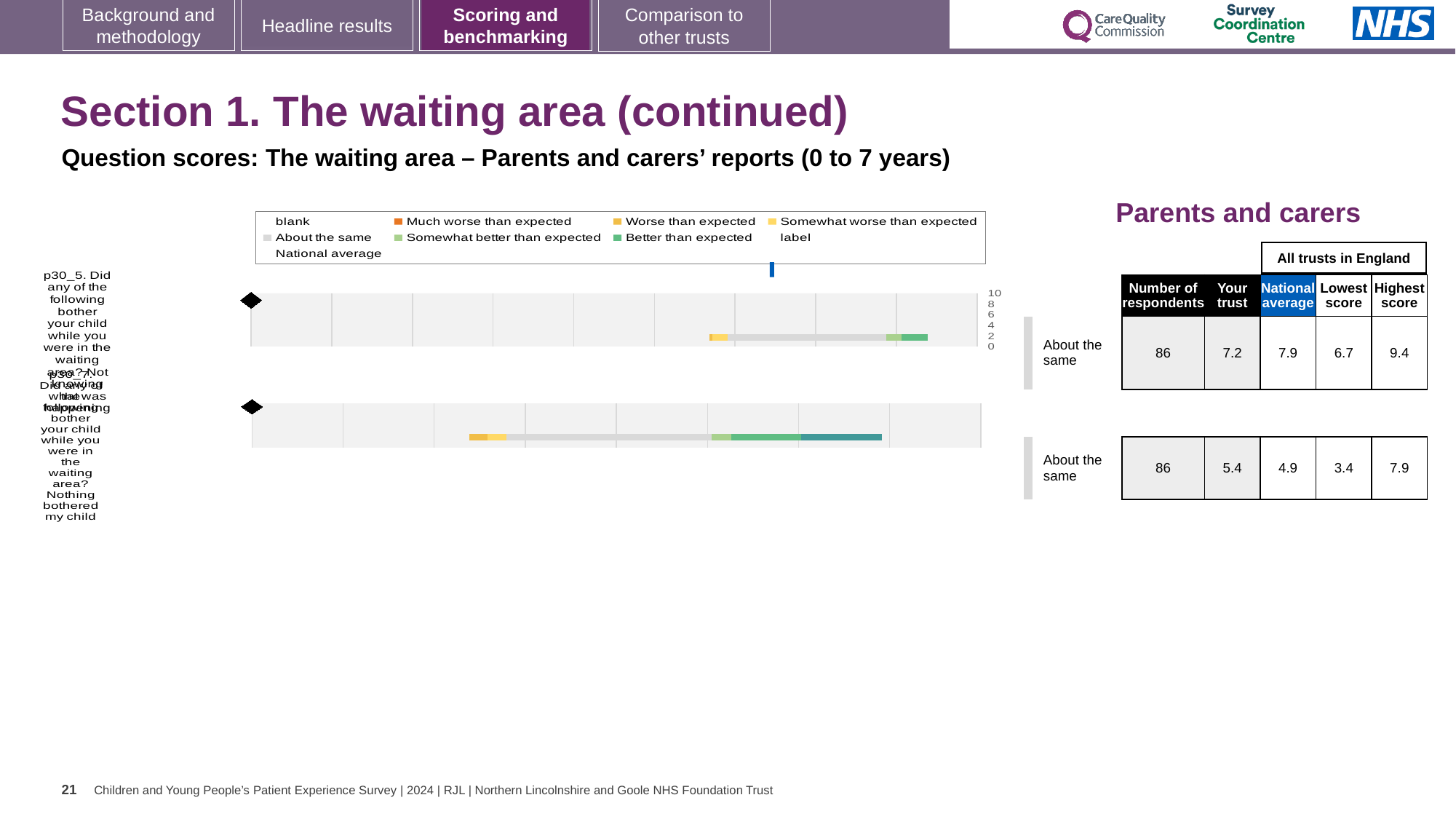
Which legend entry is shown in orange? Much worse than expected How many questions (bars) are plotted in the chart? 2 In the table beside the chart, what is the 'Your trust' score for the first question (p30_5)? 7.2 In the table beside the chart, what is the highest score across all trusts in England for the first question (p30_5)? 9.4 For the second question (p30_7), which is larger: the 'Your trust' score or the national average? Your trust What kind of chart is shown on the slide? bar chart In the table beside the chart, how many respondents answered the first question (p30_5)? 86 In the table beside the chart, what is the national average for the second question (p30_7)? 4.9 In the table beside the chart, what is the lowest score across all trusts in England for the second question (p30_7)? 3.4 What benchmark category is given for both questions next to the chart? About the same For the first question (p30_5), what is the difference between the national average and the 'Your trust' score? 0.7 What is the maximum value shown on the chart's score axis? 10